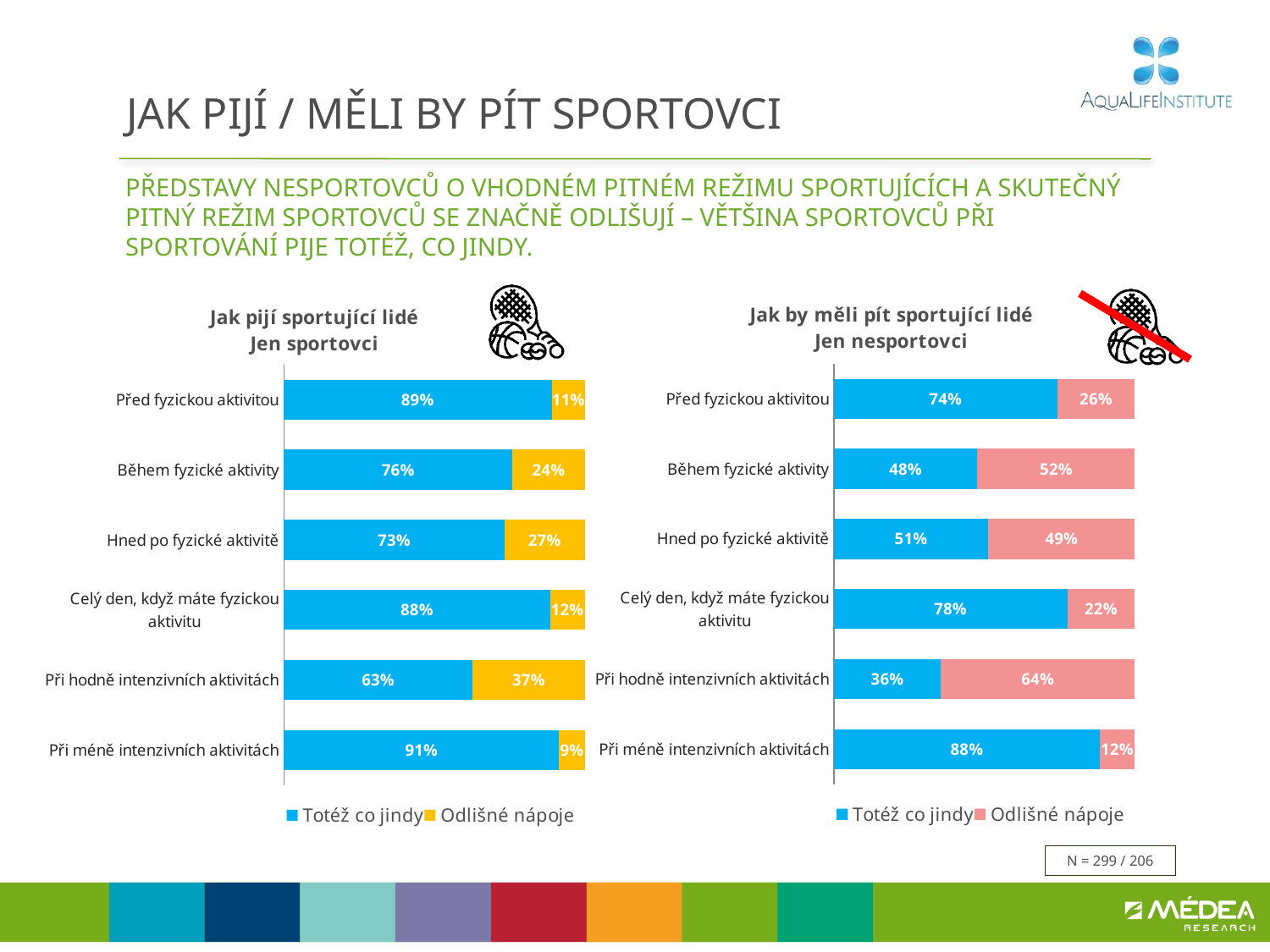
In the left chart 'Jak pijí sportující lidé – Jen sportovci', what is the value of 'Totéž co jindy' for 'Během fyzické aktivity'? 76% How many categories are shown in the left chart 'Jen sportovci'? 6 In the right chart 'Jen nesportovci', what is the total of the stacked bar for 'Před fyzickou aktivitou'? 100% In the left chart 'Jen sportovci', what is the difference between the 'Odlišné nápoje' values for 'Při hodně intenzivních aktivitách' and 'Hned po fyzické aktivitě'? 10% In the right chart 'Jen nesportovci', what is the value of 'Totéž co jindy' for 'Celý den, když máte fyzickou aktivitu'? 78% What kind of chart is the left chart 'Jen sportovci'? Stacked bar chart For 'Během fyzické aktivity', which chart shows a larger 'Totéž co jindy' value: the left chart 'Jen sportovci' or the right chart 'Jen nesportovci'? Jen sportovci In the right chart 'Jen nesportovci', which category has the lowest value for 'Totéž co jindy'? Při hodně intenzivních aktivitách What colour represents 'Odlišné nápoje' in the left chart 'Jen sportovci'? Yellow In the right chart 'Jak by měli pít sportující lidé – Jen nesportovci', what is the value of 'Odlišné nápoje' for 'Při hodně intenzivních aktivitách'? 64% In the left chart 'Jen sportovci', which category has the highest value for 'Totéž co jindy'? Při méně intenzivních aktivitách How many series does the legend of the right chart 'Jen nesportovci' list? 2